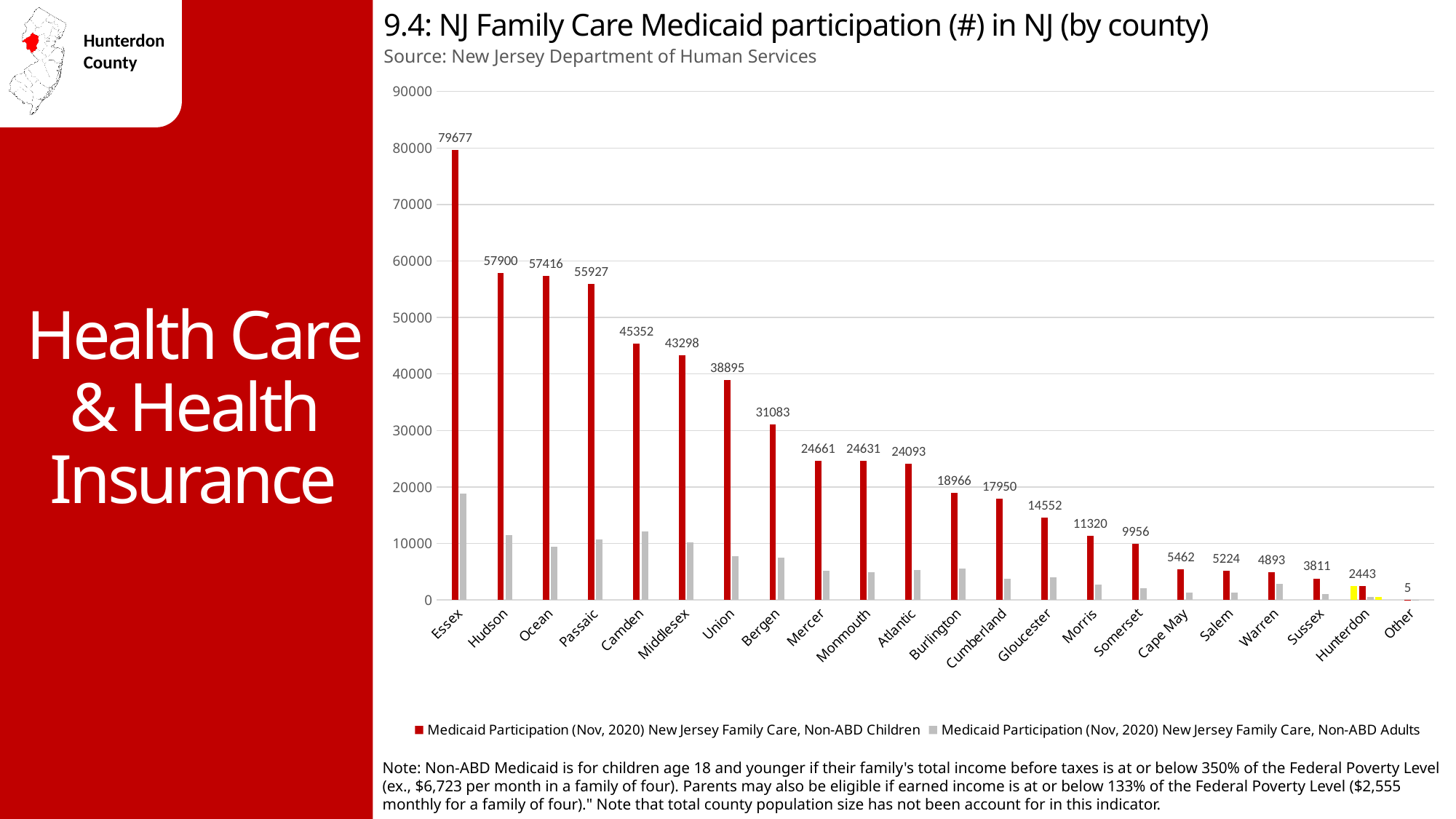
Which county has the highest Non-ABD Children Medicaid participation? Essex How many series does the legend list? 2 What kind of chart is shown on the slide? Bar chart Which category has the lowest Non-ABD Children Medicaid participation? Other What is the Non-ABD Children Medicaid participation value for Hunterdon? 2443 Do the Non-ABD Children values rise or fall from left to right along the x axis? Fall How many categories are shown on the x axis? 22 What is the Non-ABD Children Medicaid participation value for Essex? 79677 Which has a larger Non-ABD Children value, Union or Bergen? Union Is the Non-ABD Adults value for Essex greater or less than 10000? greater What is the difference between the Non-ABD Children values for Essex and Hudson? 21777 What is the Non-ABD Children Medicaid participation value for Camden? 45352